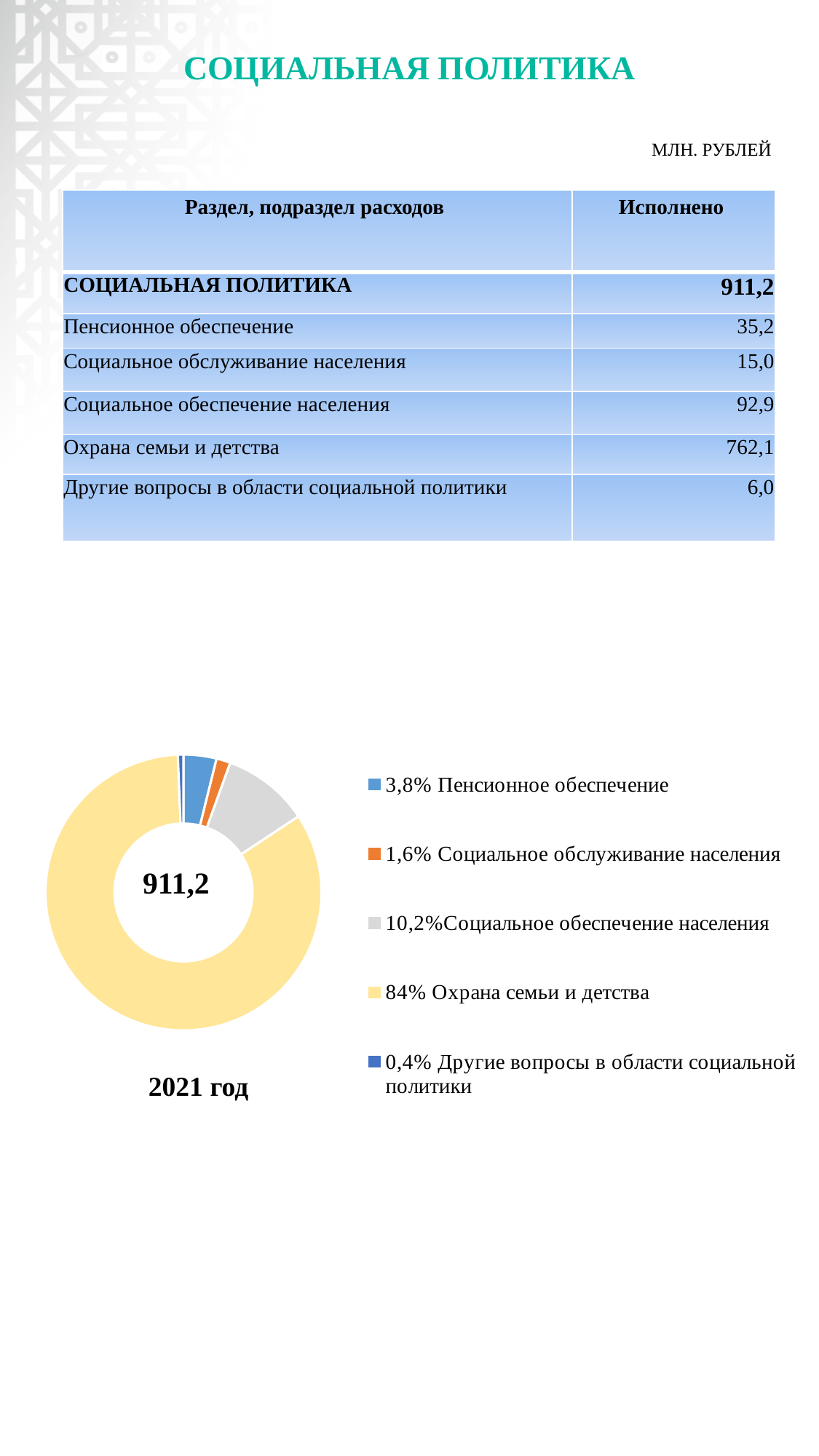
What kind of chart is shown on the slide? Doughnut (pie) chart What share of the doughnut chart does Пенсионное обеспечение take? 3,8% Which slice is larger in the doughnut chart: Пенсионное обеспечение or Социальное обеспечение населения? Социальное обеспечение населения Which category has the largest slice in the doughnut chart? Охрана семьи и детства What share of the doughnut chart does Социальное обеспечение населения take? 10,2% What share of the doughnut chart does Социальное обслуживание населения take? 1,6% What total value is printed in the centre of the doughnut chart? 911,2 Which category has the smallest slice in the doughnut chart? Другие вопросы в области социальной политики How many categories does the legend of the doughnut chart list? 5 What year label is shown below the doughnut chart? 2021 год